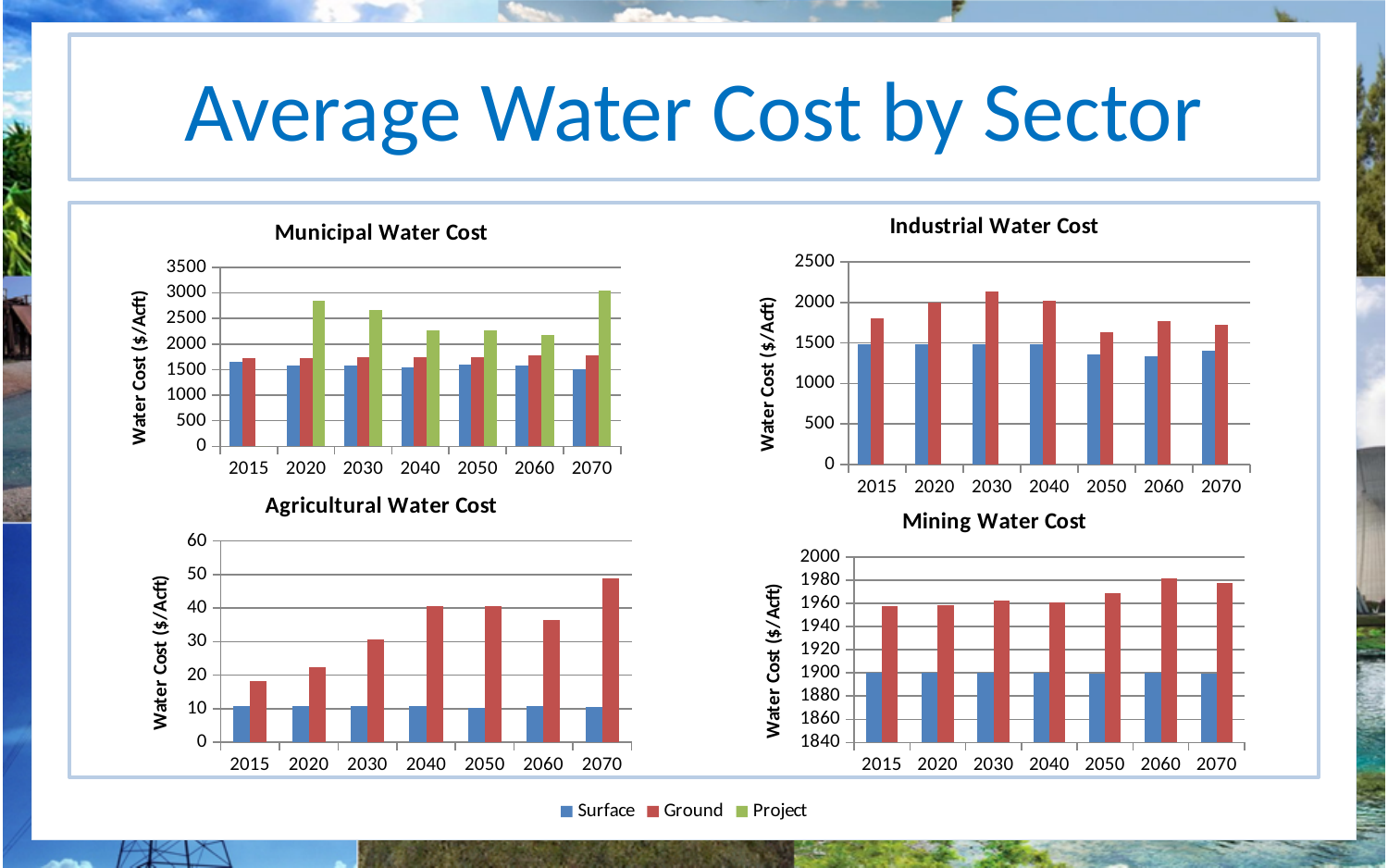
In the Municipal Water Cost chart, which year has the highest Project bar? 2070 What kind of chart is the Municipal Water Cost chart? bar chart In the Mining Water Cost chart, which is larger for 2060, Surface or Ground? Ground In the Mining Water Cost chart, what is the Surface value for 2015? 1900 In the Municipal Water Cost chart, is the Project value for 2020 greater or less than 2500? greater In the Agricultural Water Cost chart, which year has the highest Ground value? 2070 In the Industrial Water Cost chart, which year has the highest Ground value? 2030 How many series does the shared legend at the bottom of the slide list? 3 In the Agricultural Water Cost chart, is the Ground value for 2015 greater or less than 20? less How many years are shown on the x axis of the Agricultural Water Cost chart? 7 In the Industrial Water Cost chart, is the Surface value for 2050 greater or less than 1500? less